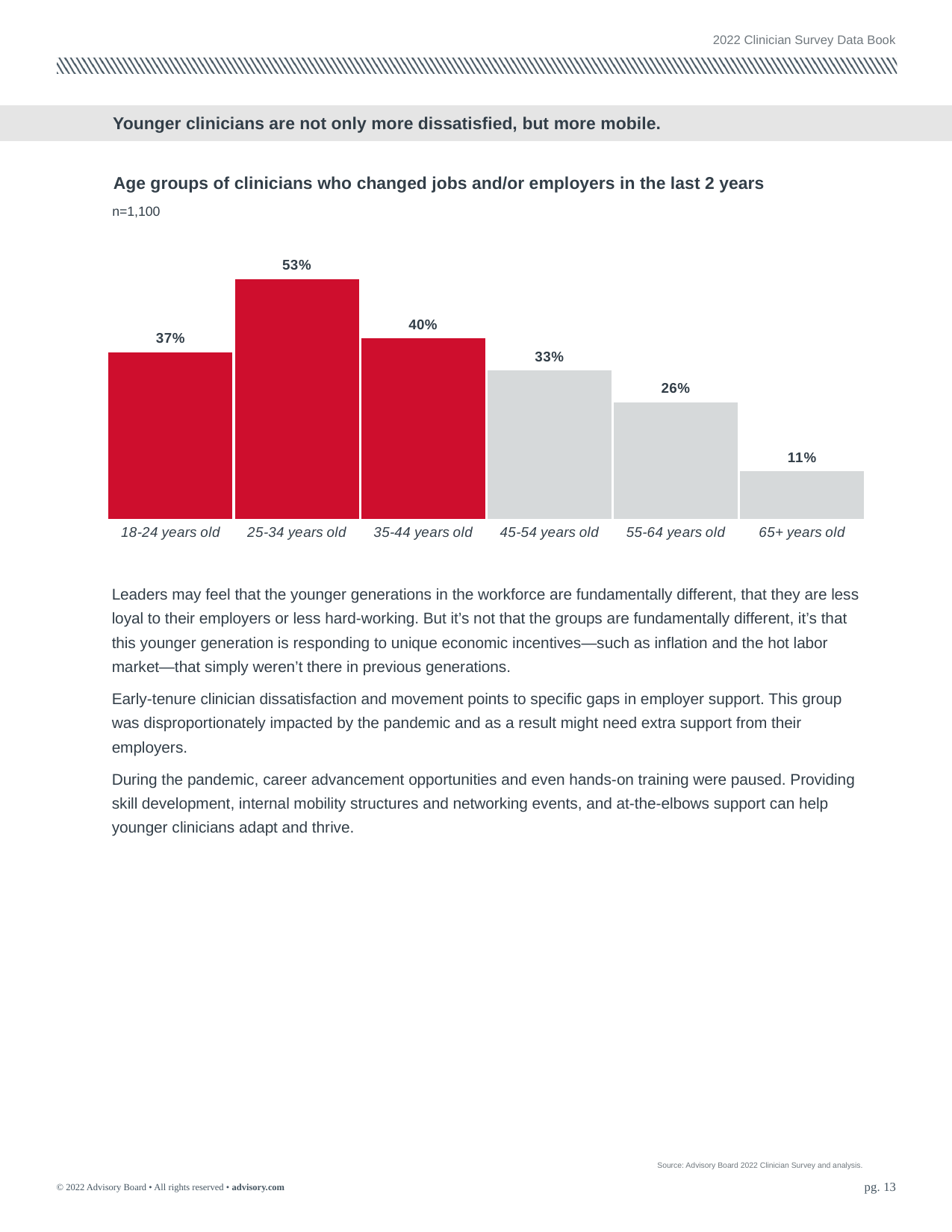
Which is larger, the value for 18-24 years old or the value for 35-44 years old? 35-44 years old Which age group has the lowest percentage of clinicians who changed jobs and/or employers? 65+ years old What is the value shown for the 45-54 years old age group? 33% What type of chart is used on this slide? Bar chart How many age groups are shown in the chart? 6 Which age group has the highest percentage of clinicians who changed jobs and/or employers? 25-34 years old What is the sample size (n) stated for the chart? n=1,100 What is the difference between the values for 35-44 years old and 55-64 years old? 14 percentage points What is the value shown for the 65+ years old age group? 11% What is the difference in percentage points between the 25-34 years old and 65+ years old groups? 42 percentage points What percentage of clinicians aged 25-34 years old changed jobs and/or employers in the last 2 years? 53% From the 25-34 years old group onward, do the values rise or fall as age increases? Fall